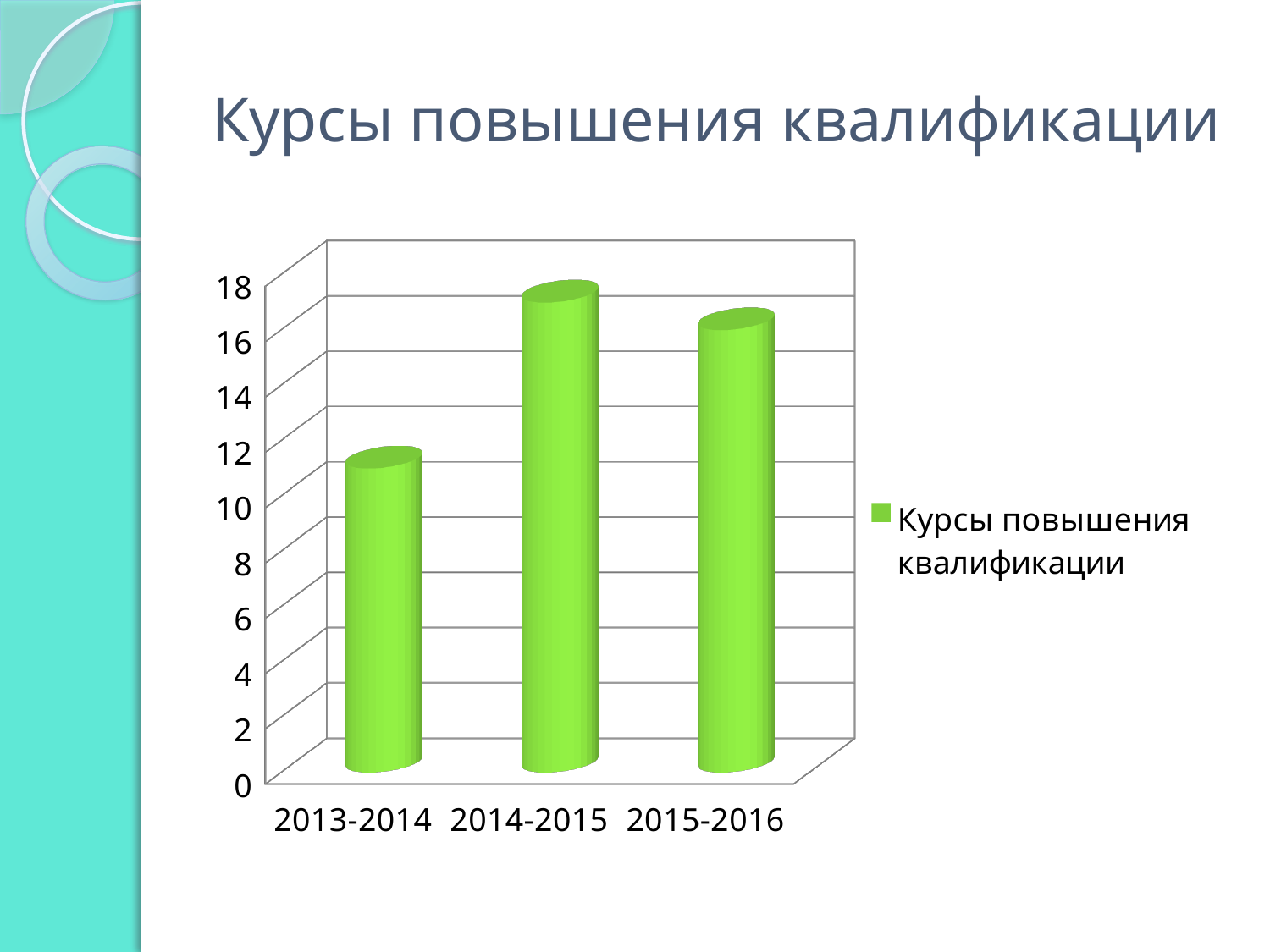
Which period has the lowest value in the chart? 2013-2014 How many categories are shown on the x axis of the chart? 3 How many series does the legend list? 1 Which period has the highest value in the chart? 2014-2015 What is the title of the chart on the slide? Курсы повышения квалификации Is the value for 2013-2014 greater or less than 14? less What is the name of the series listed in the legend? Курсы повышения квалификации Is the value for 2013-2014 greater or less than 8? greater Is the value for 2015-2016 greater or less than 12? greater What kind of chart is shown on the slide? bar chart Which is larger, the value for 2013-2014 or the value for 2015-2016? 2015-2016